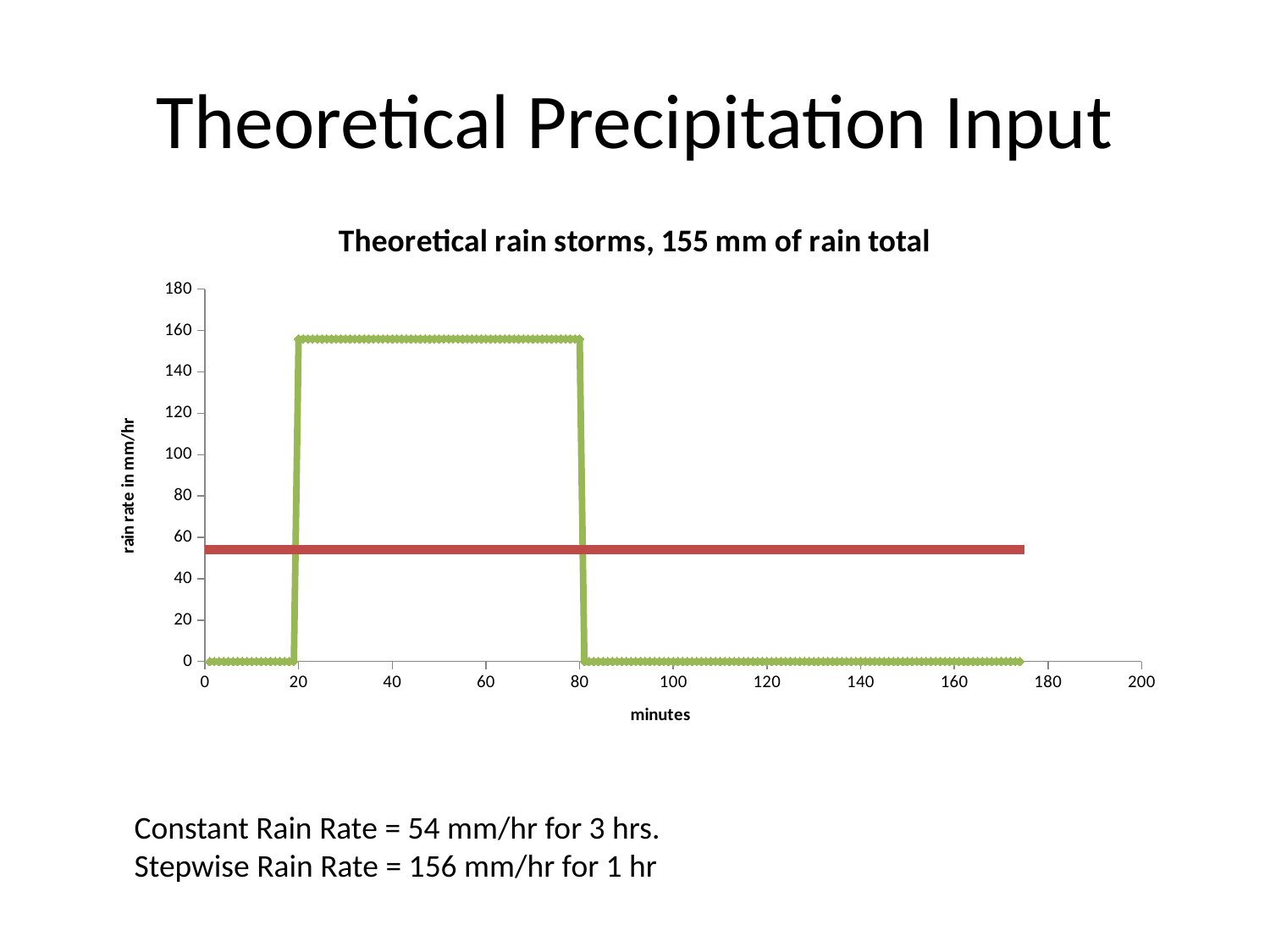
What is the label of the vertical axis of the chart? rain rate in mm/hr According to the slide, what is the difference between the stepwise rain rate and the constant rain rate? 102 mm/hr What is the value of the green line at 100 minutes? 0 What is the title of the chart? Theoretical rain storms, 155 mm of rain total Is the value of the green line at 50 minutes greater or less than 140 mm/hr? greater What kind of chart is shown on the slide? line chart Is the value of the flat red line greater or less than 40 mm/hr? greater At 120 minutes, which line has the higher rain rate, the green line or the red line? the red line Is the value of the flat red line greater or less than 60 mm/hr? less At 50 minutes, which line has the higher rain rate, the green line or the red line? the green line According to the slide, what is the constant rain rate? 54 mm/hr How many lines (series) are plotted on the chart? 2